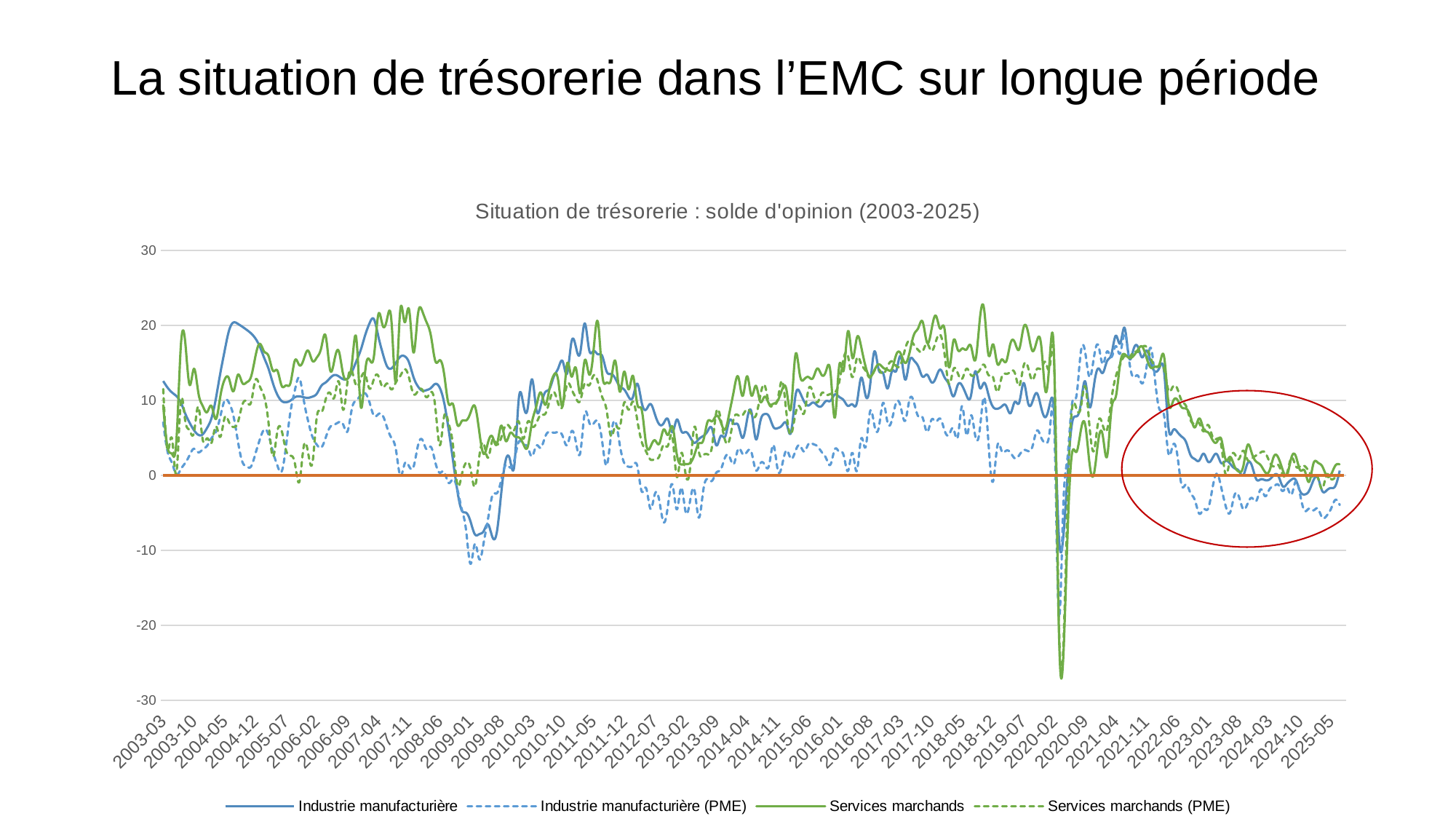
Which series reaches the lowest point on the chart, Industrie manufacturière or Services marchands? Services marchands Is the value for Services marchands around 2018-12 greater or less than 10? greater Which two series are drawn with dashed lines? Industrie manufacturière (PME) and Services marchands (PME) How many series does the legend list? 4 What is the title of the chart? Situation de trésorerie : solde d'opinion (2003-2025) Around 2020-09, is the value for Industrie manufacturière greater or less than 10? greater From 2022-06 to 2025-05, do the values for Services marchands rise or fall overall? fall Is the value for Industrie manufacturière around 2009-01 greater or less than 0? less What kind of chart is shown on the slide? line chart